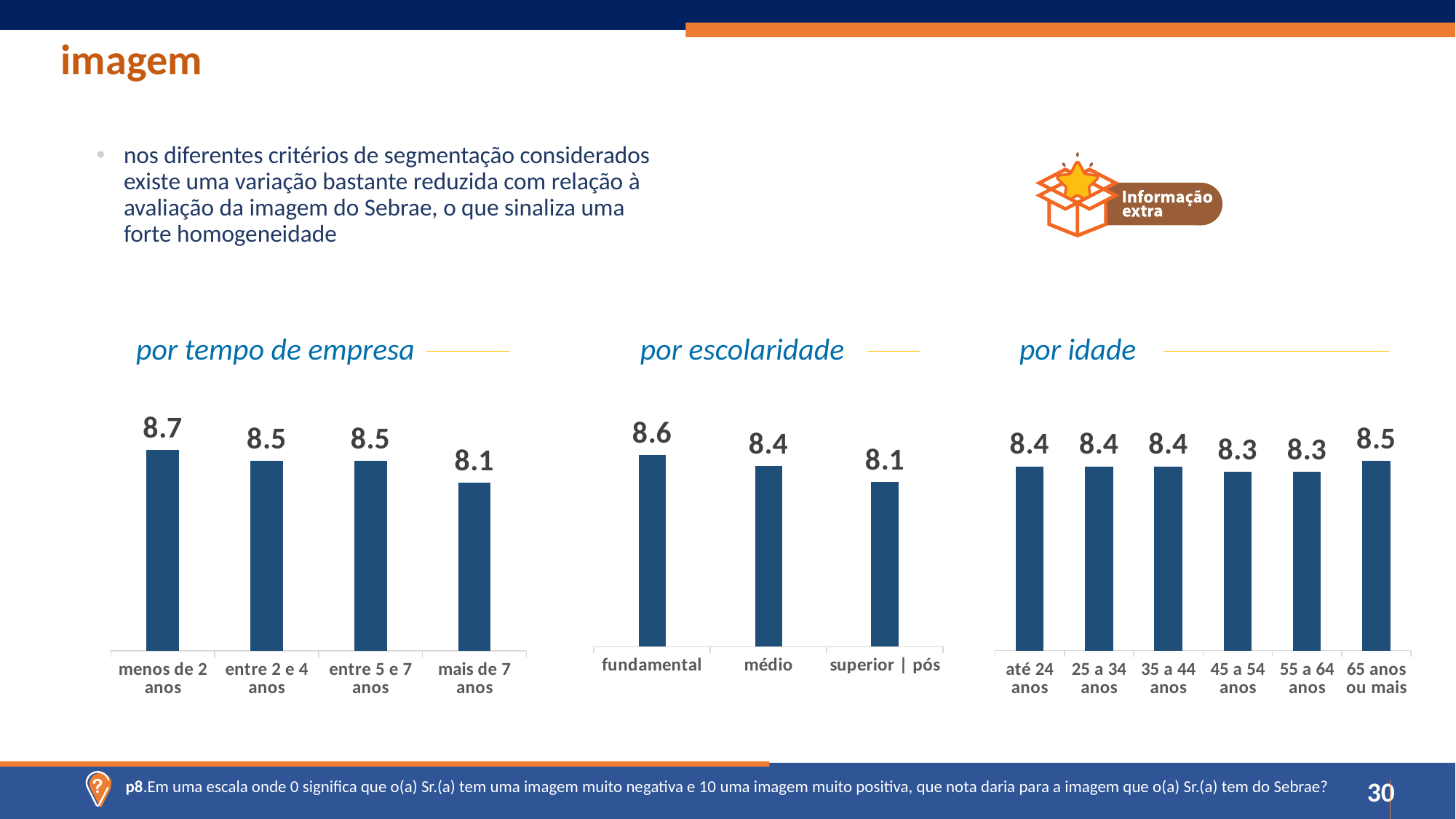
In the 'por escolaridade' chart, what is the value for 'médio'? 8.4 In the 'por idade' chart, what is the value for '65 anos ou mais'? 8.5 In the 'por tempo de empresa' chart, what is the difference between 'menos de 2 anos' and 'mais de 7 anos'? 0.6 In the 'por idade' chart, how many age categories are shown? 6 In the 'por tempo de empresa' chart, which category has the lowest value? mais de 7 anos In the 'por escolaridade' chart, what is the difference between 'fundamental' and 'superior | pós'? 0.5 In the 'por idade' chart, which is larger, the value for '45 a 54 anos' or '65 anos ou mais'? 65 anos ou mais In the 'por tempo de empresa' chart, how many categories are shown? 4 In the 'por escolaridade' chart, do the values rise or fall from left to right? fall In the 'por tempo de empresa' chart, what is the value for 'menos de 2 anos'? 8.7 What type of chart is the 'por idade' chart? bar chart In the 'por escolaridade' chart, which category has the highest value? fundamental